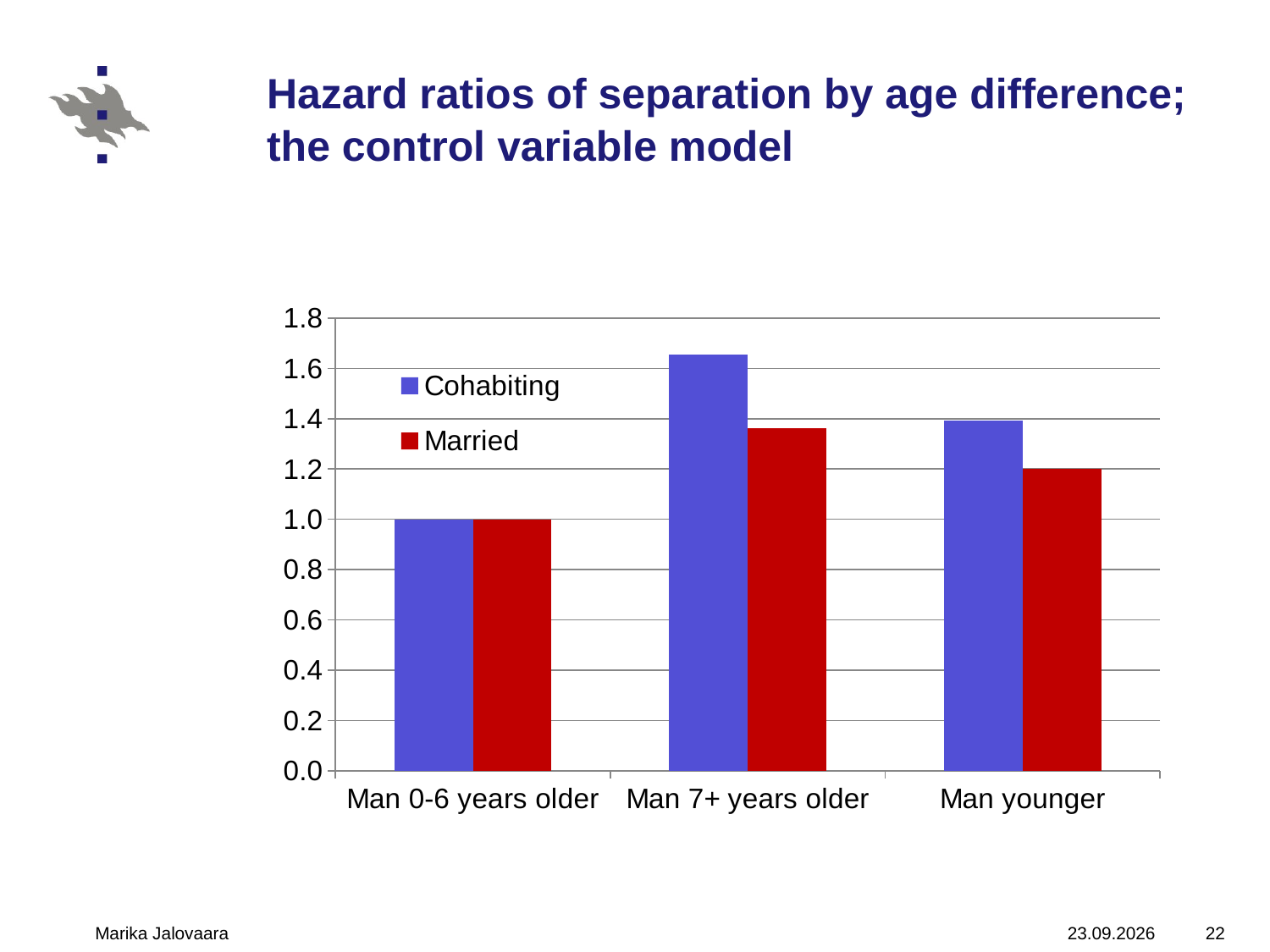
Which colour represents the Married series in the legend? red For 'Man younger', which series has the larger hazard ratio, Cohabiting or Married? Cohabiting Is the Cohabiting value for 'Man younger' greater or less than 1.2? greater Which category has the lowest Married hazard ratio? Man 0-6 years older How many series does the legend list? 2 Is the Married value for 'Man 7+ years older' greater or less than 1.4? less How many age-difference categories are shown on the x axis? 3 What is the Cohabiting hazard ratio for 'Man 0-6 years older'? 1.0 Is the Cohabiting value for 'Man 7+ years older' greater or less than 1.6? greater What is the Married hazard ratio for 'Man 0-6 years older'? 1.0 Which category has the highest Cohabiting hazard ratio? Man 7+ years older What kind of chart is shown on the slide? bar chart